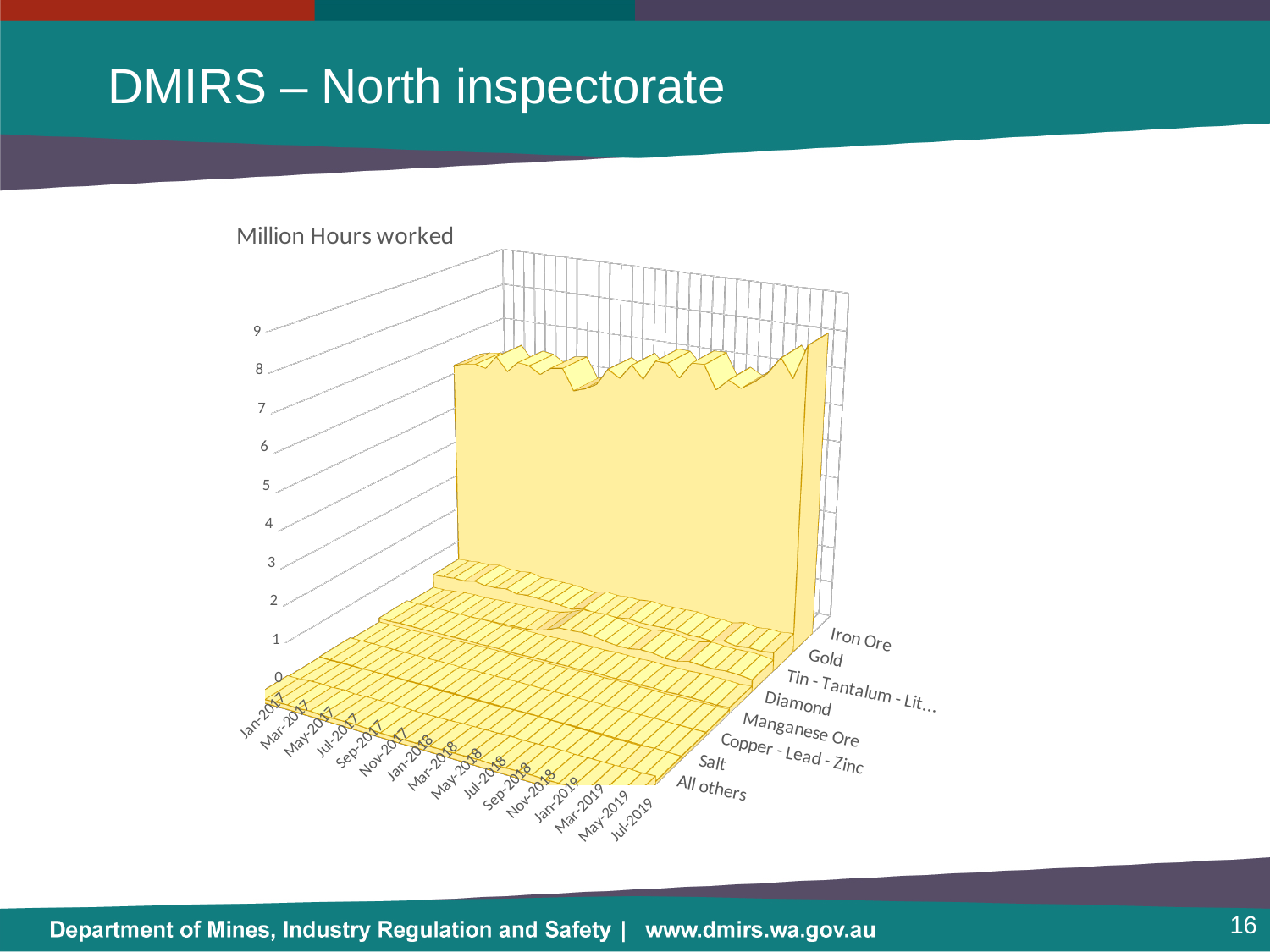
How many month labels are shown along the x axis of the chart? 16 What is the highest value shown on the vertical axis of the chart? 9 Which commodity series has the highest hours worked in the chart? Iron Ore What is the first month label on the x axis of the chart? Jan-2017 How many commodity series are plotted along the depth axis of the chart? 8 Which series has larger values, Iron Ore or All others? Iron Ore Is the value for Iron Ore in Jan-2017 greater or less than 5? greater What kind of chart is shown on the slide? 3D area chart Is the value for Salt in Jan-2017 greater or less than 2? less Which series has larger values, Iron Ore or Gold? Iron Ore What is the title of the chart? Million Hours worked What is the last month label on the x axis of the chart? Jul-2019